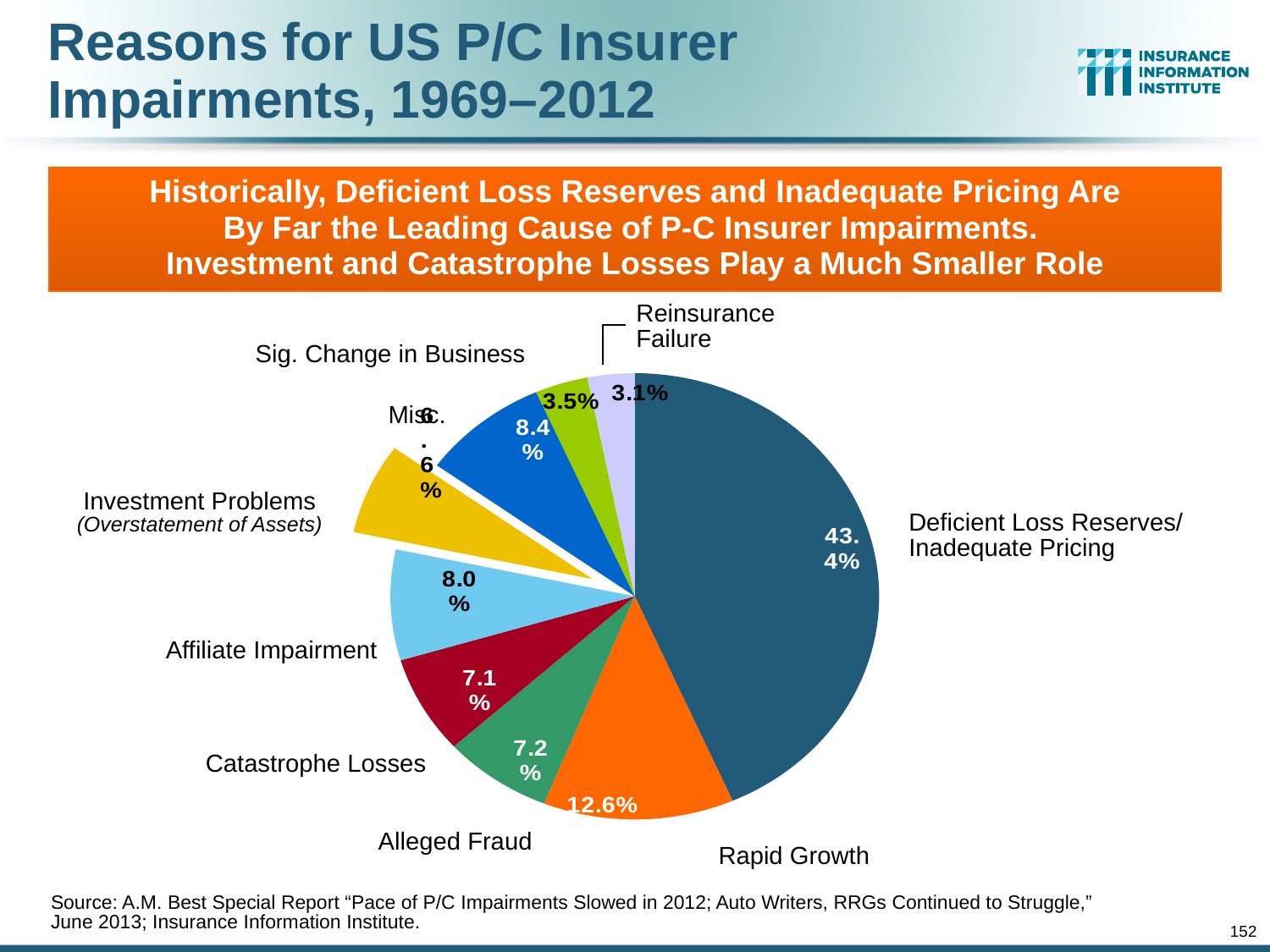
What share of US P/C insurer impairments is attributed to Deficient Loss Reserves/Inadequate Pricing? 43.4% How many slices does the pie chart have? 9 What percentage of impairments is attributed to Reinsurance Failure? 3.1% What percentage of impairments is attributed to Catastrophe Losses? 7.1% What percentage of impairments is attributed to Alleged Fraud? 7.2% How many percentage points larger is the Deficient Loss Reserves/Inadequate Pricing share than the Rapid Growth share? 30.8 percentage points Which reason accounts for the smallest share of impairments? Reinsurance Failure What percentage of impairments is attributed to Affiliate Impairment? 8.0% Which has the larger share, Rapid Growth or Affiliate Impairment? Rapid Growth Which reason accounts for the largest share of impairments? Deficient Loss Reserves/Inadequate Pricing What percentage of impairments is attributed to Rapid Growth? 12.6% What kind of chart is shown on the slide? Pie chart